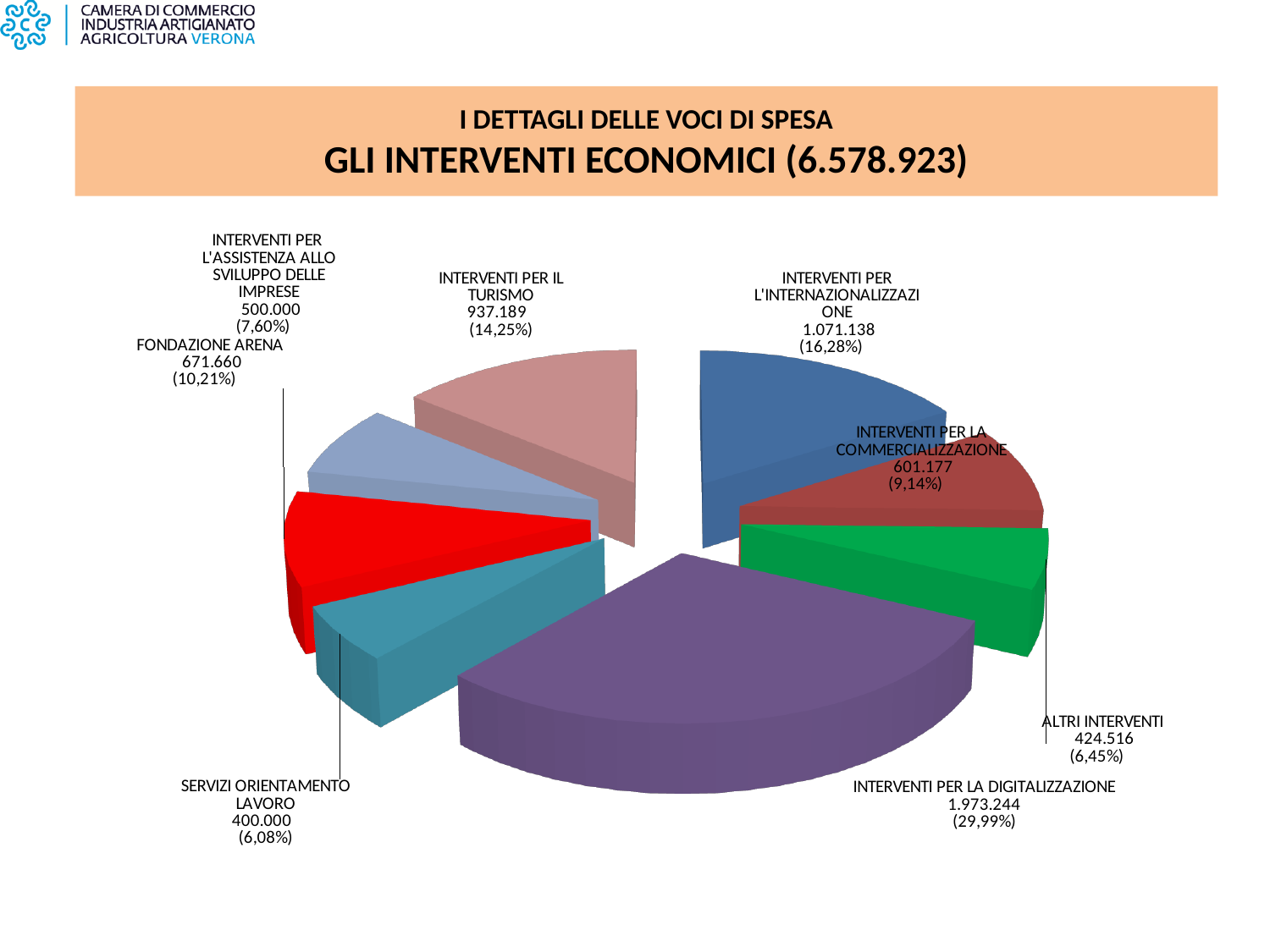
What share of the pie does ALTRI INTERVENTI represent? 6,45% Which category has the largest slice? INTERVENTI PER LA DIGITALIZZAZIONE What is the value for INTERVENTI PER IL TURISMO? 937.189 What is the value for FONDAZIONE ARENA? 671.660 Which category has the smallest slice? SERVIZI ORIENTAMENTO LAVORO What total amount is given in the slide title for the economic interventions? 6.578.923 How many slices does the pie chart have? 8 What is the difference between the values for INTERVENTI PER LA DIGITALIZZAZIONE and INTERVENTI PER L'INTERNAZIONALIZZAZIONE? 902.106 What type of chart is shown on the slide? Pie chart What share of the pie does INTERVENTI PER L'INTERNAZIONALIZZAZIONE represent? 16,28% What is the value for INTERVENTI PER LA DIGITALIZZAZIONE? 1.973.244 Which is larger, the value for INTERVENTI PER LA COMMERCIALIZZAZIONE or the value for FONDAZIONE ARENA? FONDAZIONE ARENA